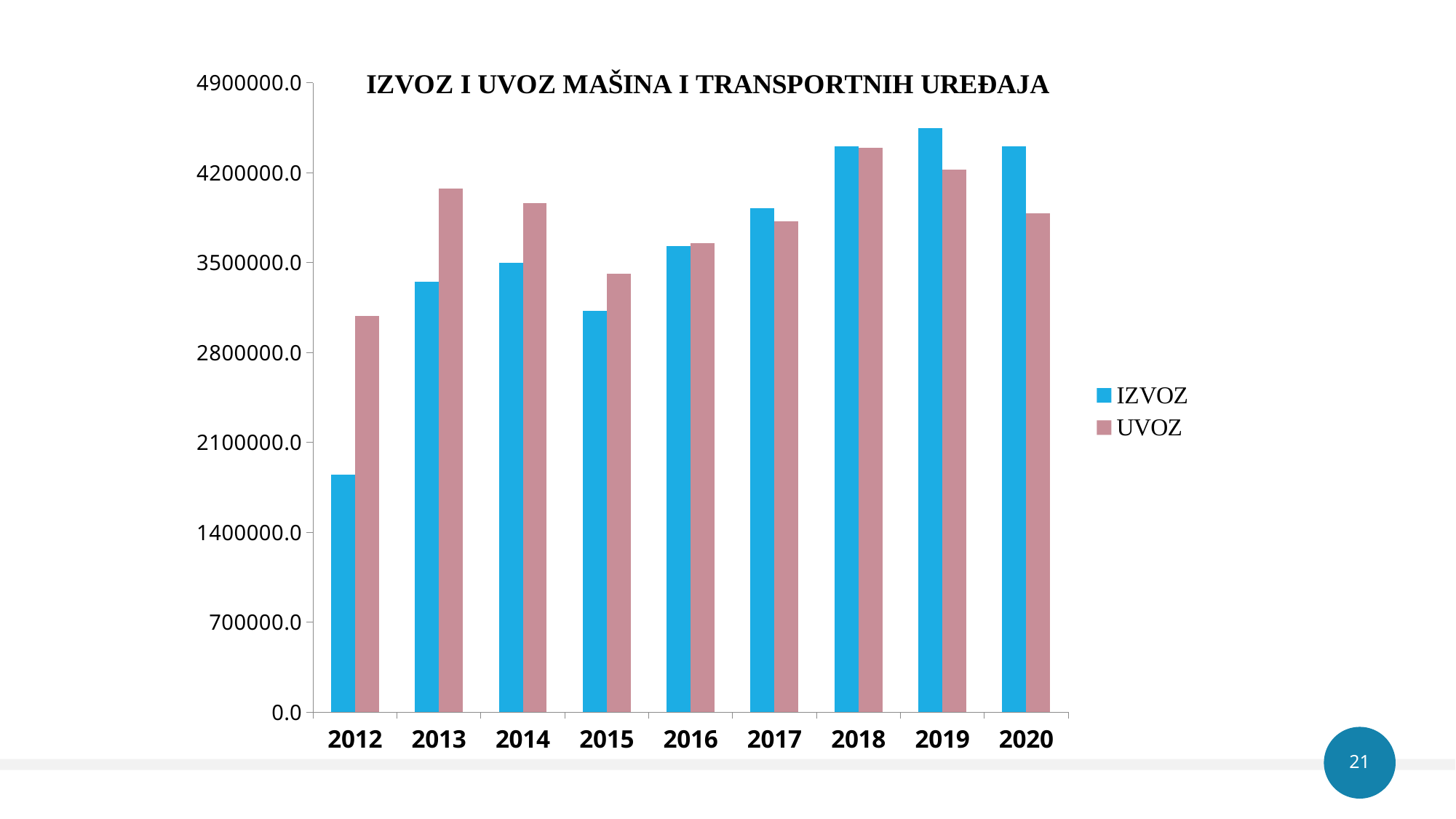
How many years are shown on the x axis? 9 Which year has the lowest IZVOZ value? 2012 Which year has the highest IZVOZ value? 2019 What is the title of the chart? IZVOZ I UVOZ MAŠINA I TRANSPORTNIH UREĐAJA In 2012, which is larger, IZVOZ or UVOZ? UVOZ In 2019, which is larger, IZVOZ or UVOZ? IZVOZ Is the IZVOZ value for 2012 greater or less than 2100000.0? less What kind of chart is shown on the slide? bar chart Is the UVOZ value for 2020 greater or less than 3500000.0? greater How many series does the legend list? 2 Which year has the lowest UVOZ value? 2012 Is the IZVOZ value for 2019 greater or less than 4200000.0? greater